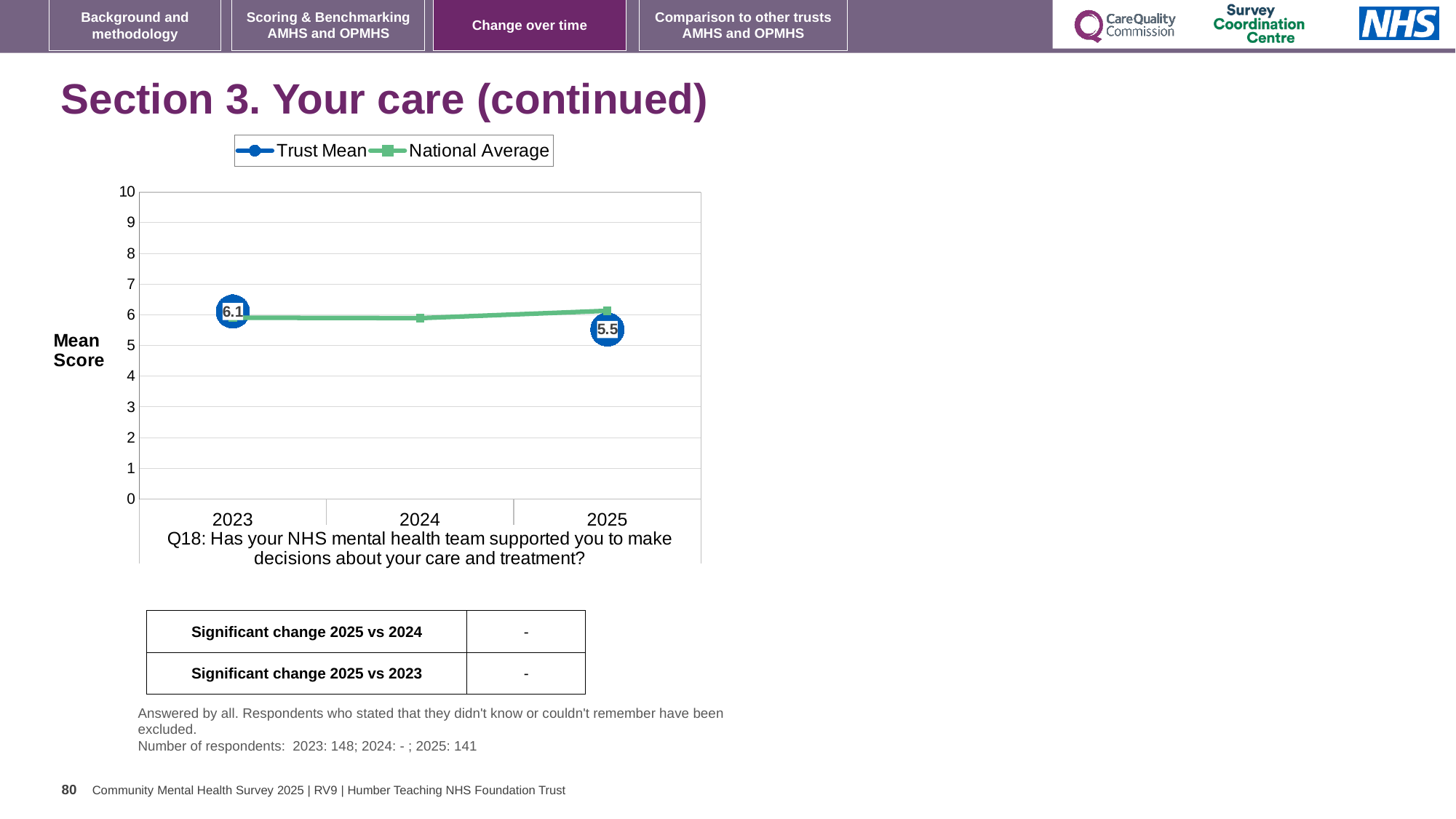
What is the Trust Mean score for 2023? 6.1 Is the National Average value for 2024 greater or less than 7? less Is the National Average value for 2025 greater or less than 5? greater In 2025, which series is higher, Trust Mean or National Average? National Average What is the difference between the Trust Mean scores for 2023 and 2025? 0.6 How many years are shown on the x axis? 3 Which year has the higher Trust Mean score, 2023 or 2025? 2023 What is the Trust Mean score for 2025? 5.5 Does the Trust Mean rise or fall from 2023 to 2025? fall What is the label on the y axis of the chart? Mean Score How many series does the legend list? 2 What kind of chart is shown on the slide? line chart